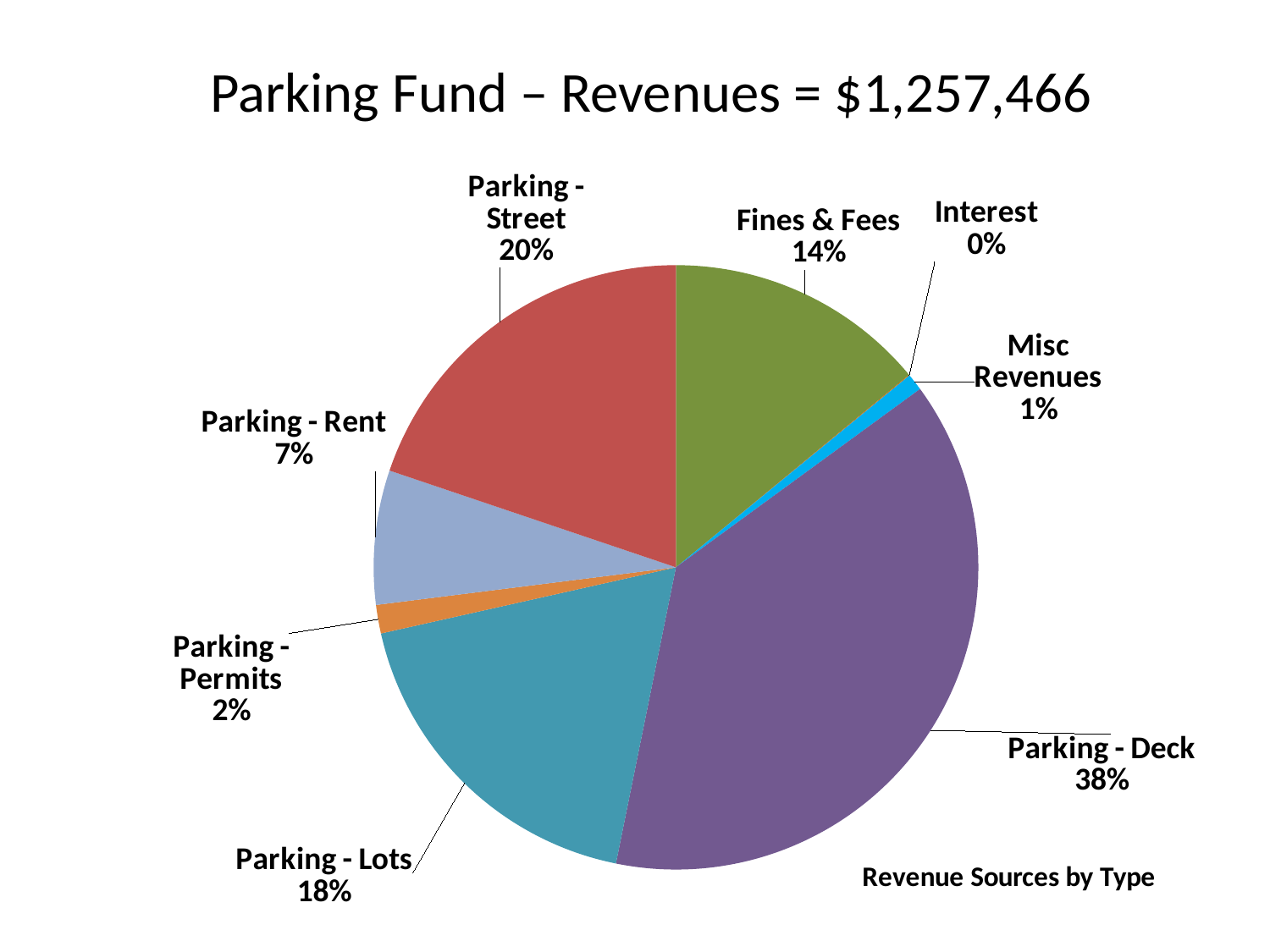
What share of the pie does Parking - Street represent? 20% What share of the pie does Parking - Deck represent? 38% Which is larger, Parking - Lots or Parking - Rent? Parking - Lots What share of the pie does Fines & Fees represent? 14% What kind of chart is shown on the slide? Pie chart How many categories are shown in the pie chart? 8 What is the total revenue amount stated in the slide title? $1,257,466 Which category has the largest slice of the pie? Parking - Deck Which category has the smallest slice of the pie? Interest What is the difference in percentage points between Parking - Deck and Parking - Street? 18